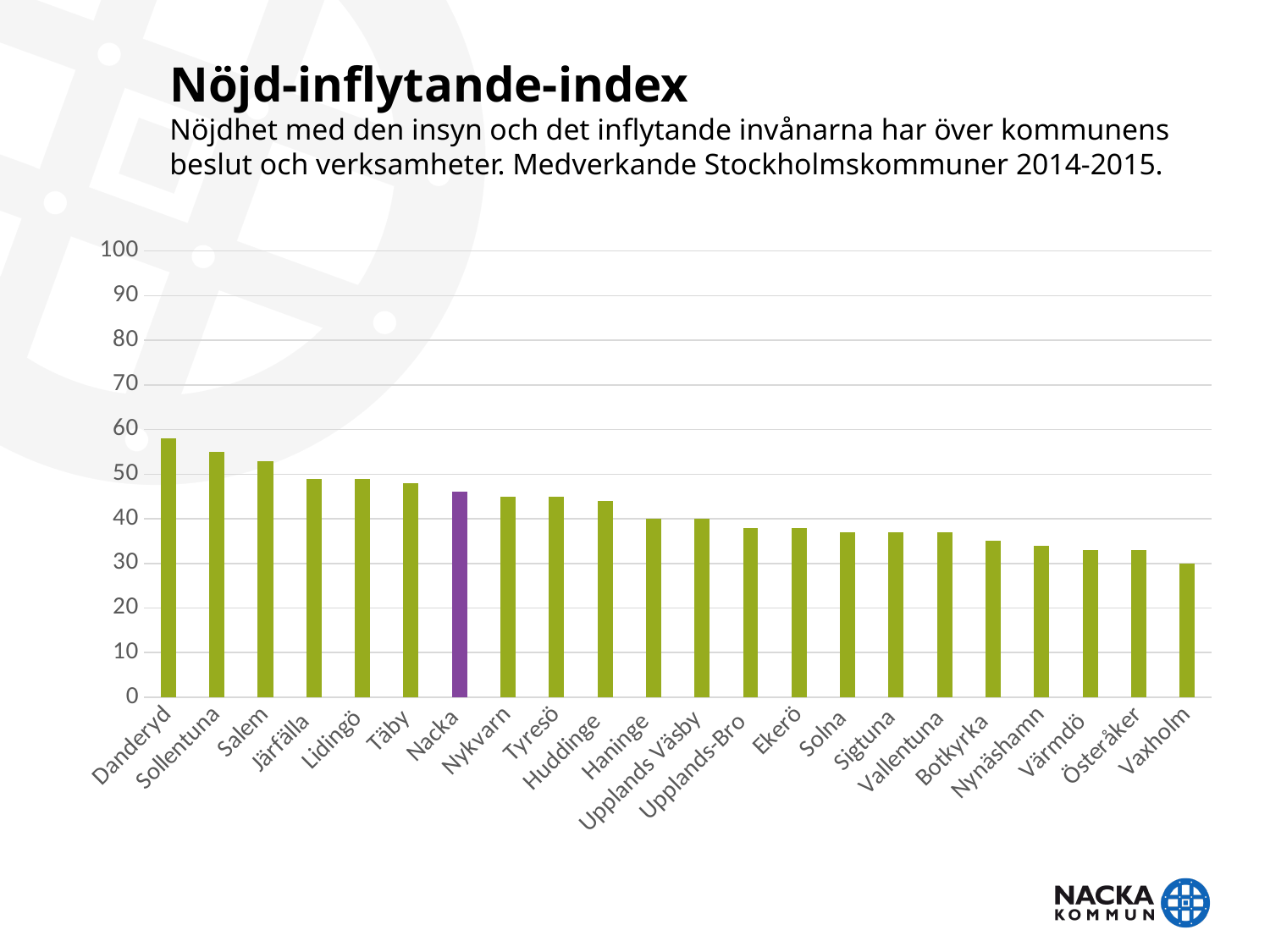
Which has a higher value, Salem or Nacka? Salem Is the value for Botkyrka greater or less than 40? less Do the values rise or fall from left to right along the x axis? Fall Which municipality has the highest Nöjd-inflytande-index value? Danderyd Which municipality has the lowest Nöjd-inflytande-index value? Vaxholm How many municipalities are shown in the chart? 22 Is the value for Nacka greater or less than 50? less Is the value for Danderyd greater or less than 50? greater Which municipality's bar is shown in purple instead of green? Nacka Which has a higher value, Vaxholm or Sollentuna? Sollentuna What kind of chart is shown on the slide? Bar chart